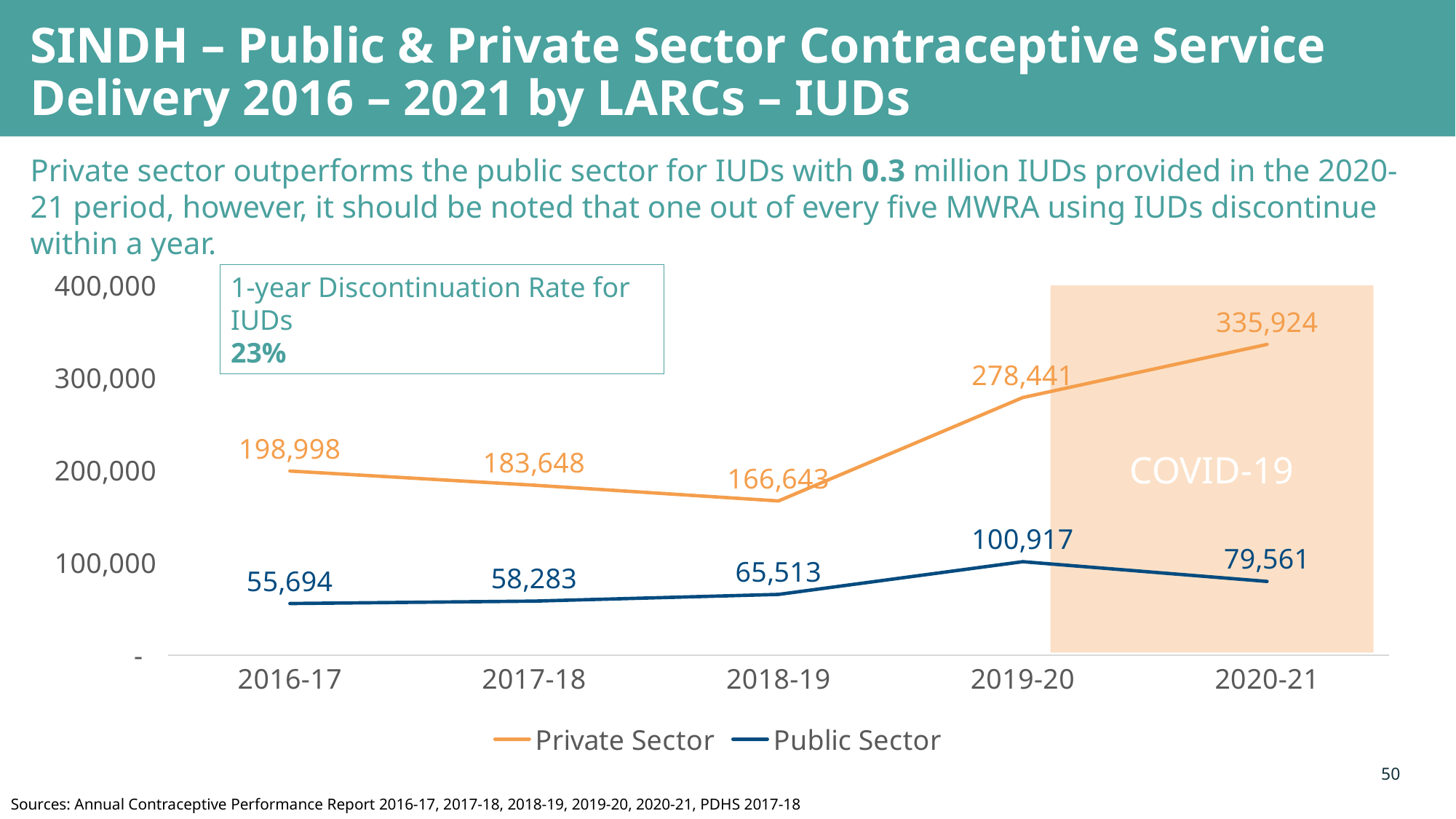
What 1-year discontinuation rate for IUDs is shown in the box on the chart? 23% In which year is the Public Sector value highest? 2019-20 What is the Private Sector value for 2020-21? 335,924 In which year is the Private Sector value lowest? 2018-19 How many years are plotted along the x axis? 5 What is the Private Sector value for 2017-18? 183,648 Which is larger in 2016-17, the Private Sector value or the Public Sector value? Private Sector By how much did the Public Sector value fall from 2019-20 to 2020-21? 21,356 How many series does the legend list? 2 What type of chart is shown on the slide? Line chart What is the Public Sector value for 2018-19? 65,513 What is the difference between the Private Sector and Public Sector values in 2020-21? 256,363